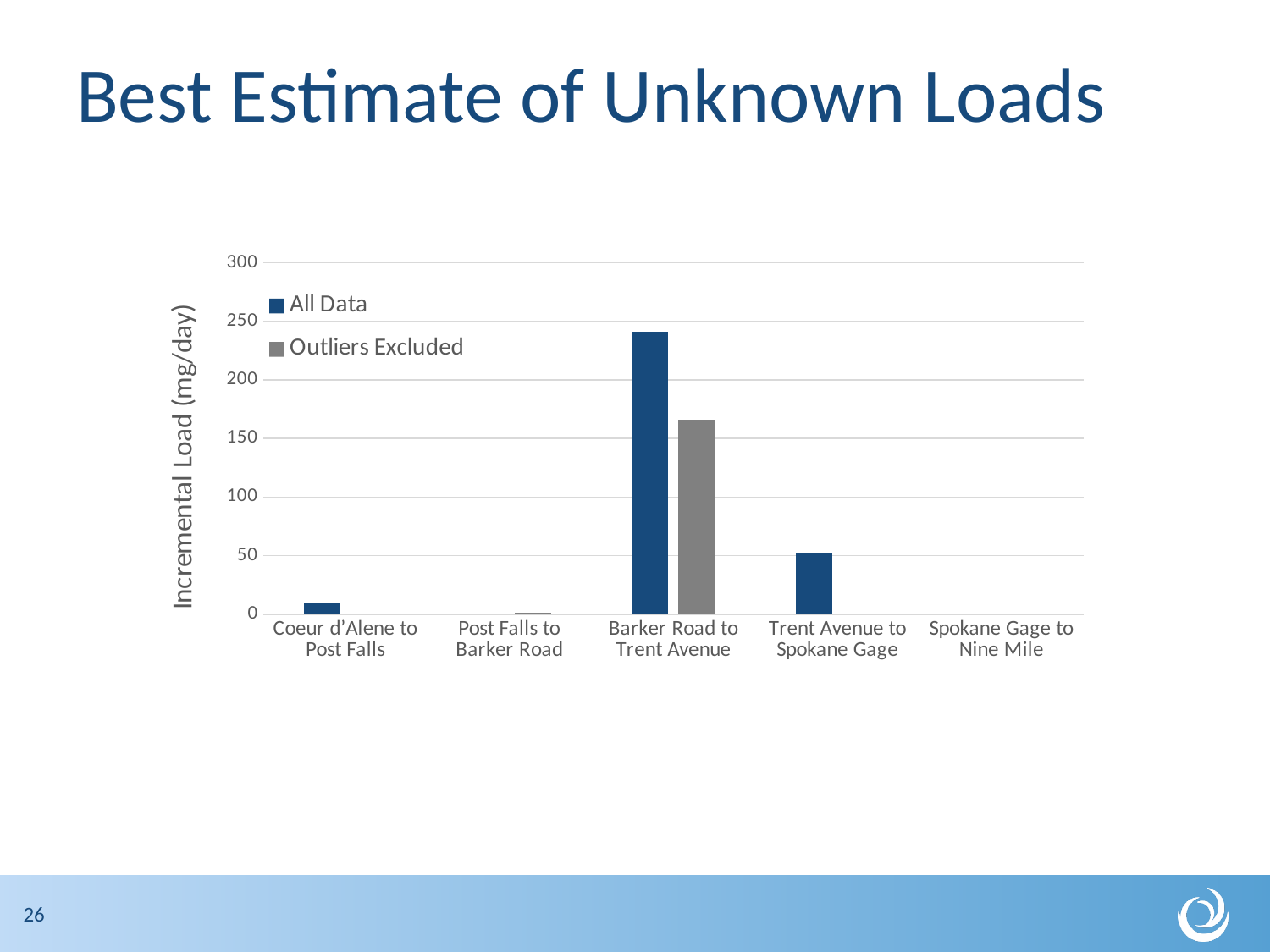
How many river reach categories are shown on the x axis? 5 How many series does the legend list? 2 Which is larger: the All Data value for Trent Avenue to Spokane Gage or the All Data value for Coeur d'Alene to Post Falls? Trent Avenue to Spokane Gage What is the label on the y axis of the chart? Incremental Load (mg/day) Which category has the highest All Data value? Barker Road to Trent Avenue Is the Outliers Excluded value for Barker Road to Trent Avenue greater or less than 150? greater What kind of chart is shown on the slide? bar chart Is the All Data value for Coeur d'Alene to Post Falls greater or less than 50? less For Barker Road to Trent Avenue, which is larger: the All Data value or the Outliers Excluded value? All Data Which category has the highest Outliers Excluded value? Barker Road to Trent Avenue Is the All Data value for Trent Avenue to Spokane Gage greater or less than 100? less